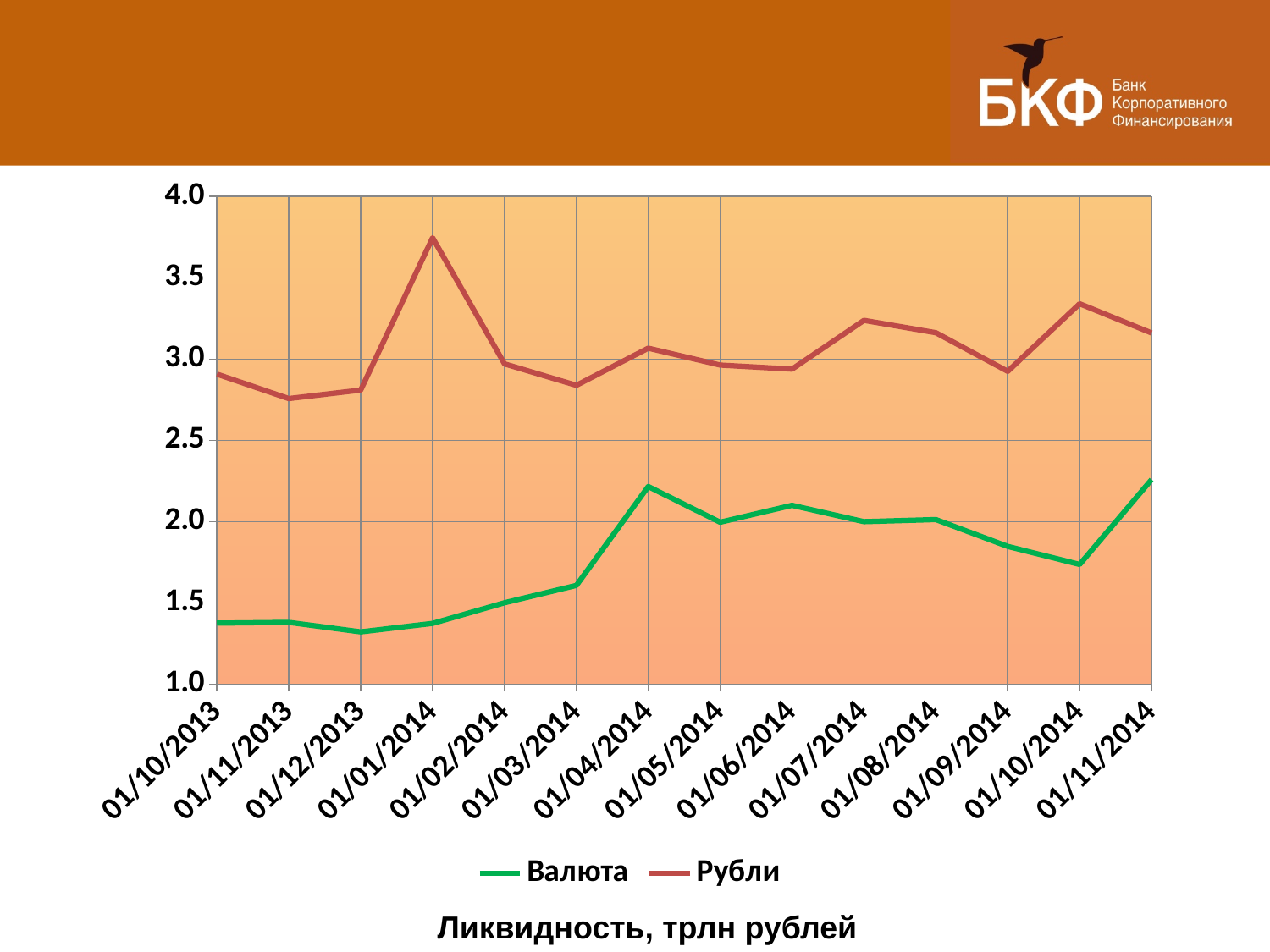
How many series does the legend list? 2 Is the value for Рубли on 01/11/2013 greater or less than 3.0? less How many dates are shown along the x axis? 14 Is the value for Рубли on 01/01/2014 greater or less than 3.5? greater On which date does the Рубли series reach its highest value? 01/01/2014 Which series has the larger value on 01/06/2014, Валюта or Рубли? Рубли Does the Валюта series rise or fall between 01/12/2013 and 01/04/2014? rise Is the value for Валюта on 01/10/2013 greater or less than 1.5? less What is the title of the chart? Ликвидность, трлн рублей Which colour is used for the Валюта series? green What kind of chart is shown on the slide? line chart